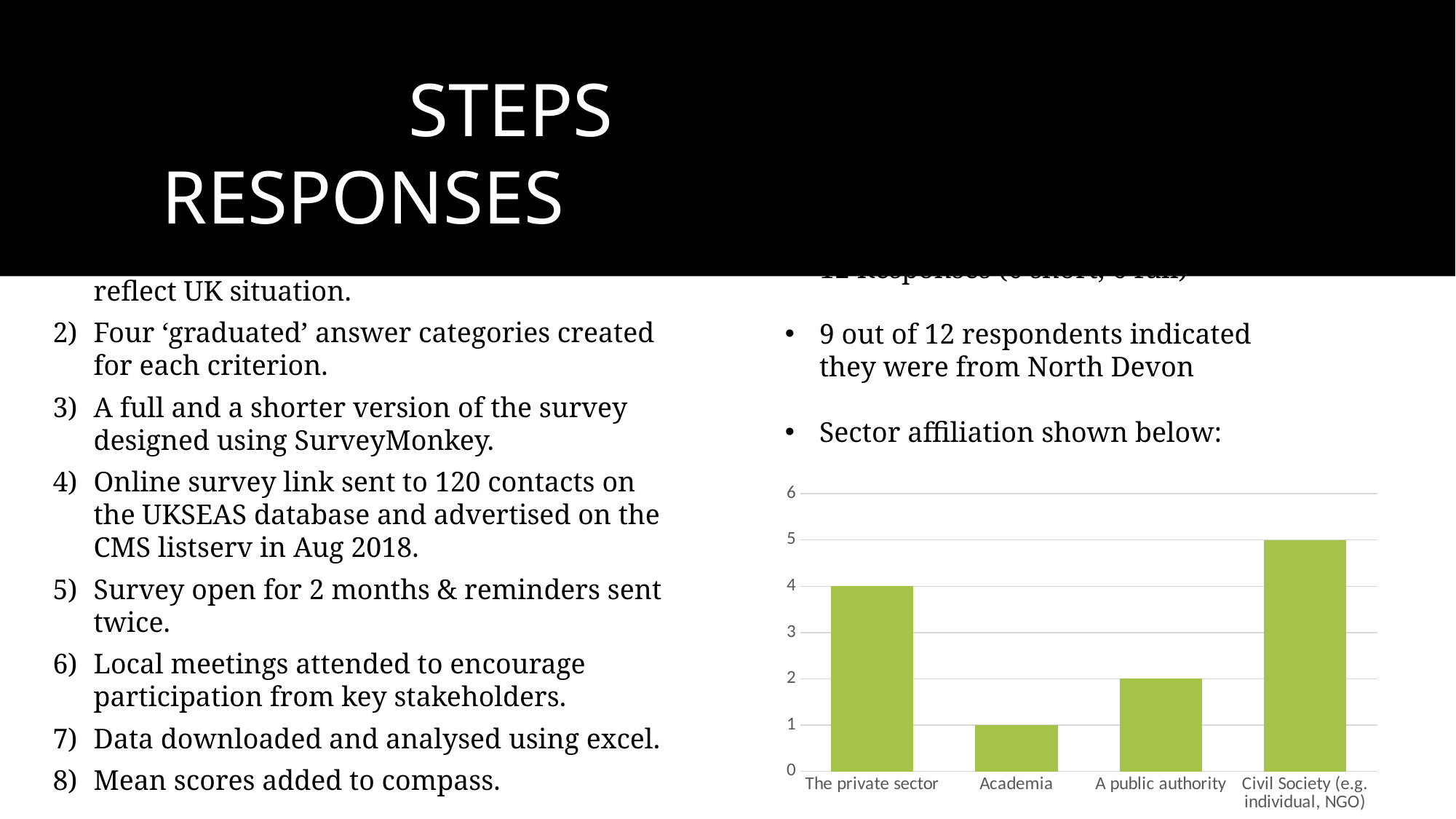
Which category has the highest value in the chart? Civil Society (e.g. individual, NGO) What is the highest value shown on the chart's y axis? 6 What is the value for Civil Society (e.g. individual, NGO) in the chart? 5 What kind of chart is shown on the slide? bar chart What is the value for The private sector in the chart? 4 Which category has the lowest value in the chart? Academia Which is larger, the value for The private sector or the value for A public authority? The private sector What is the difference between the values for Civil Society (e.g. individual, NGO) and The private sector? 1 Is the value for Civil Society (e.g. individual, NGO) greater or less than 3? greater What is the value for Academia in the chart? 1 What is the value for A public authority in the chart? 2 How many categories are shown on the x axis of the chart? 4